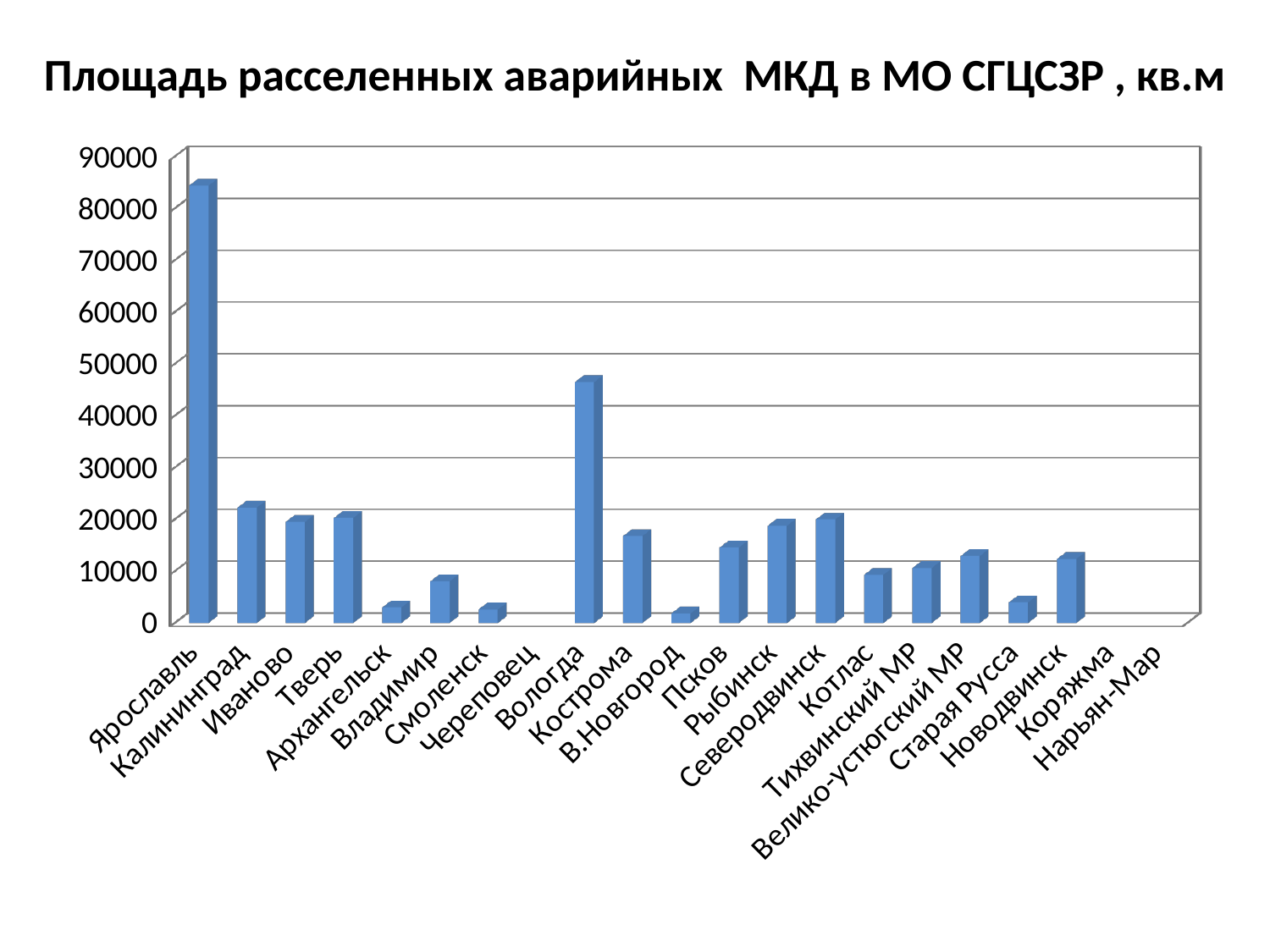
Is the value for Вологда greater or less than 40000? greater Which category has the highest value? Ярославль Is the value for Кострома greater or less than 20000? less How many categories are shown on the x axis? 21 What kind of chart is shown on the slide? bar chart Is the value for Псков greater or less than 10000? greater Which is larger, the value for Рыбинск or the value for Псков? Рыбинск What is the title of the chart? Площадь расселенных аварийных МКД в МО СГЦСЗР , кв.м Which is larger, the value for Ярославль or the value for Вологда? Ярославль